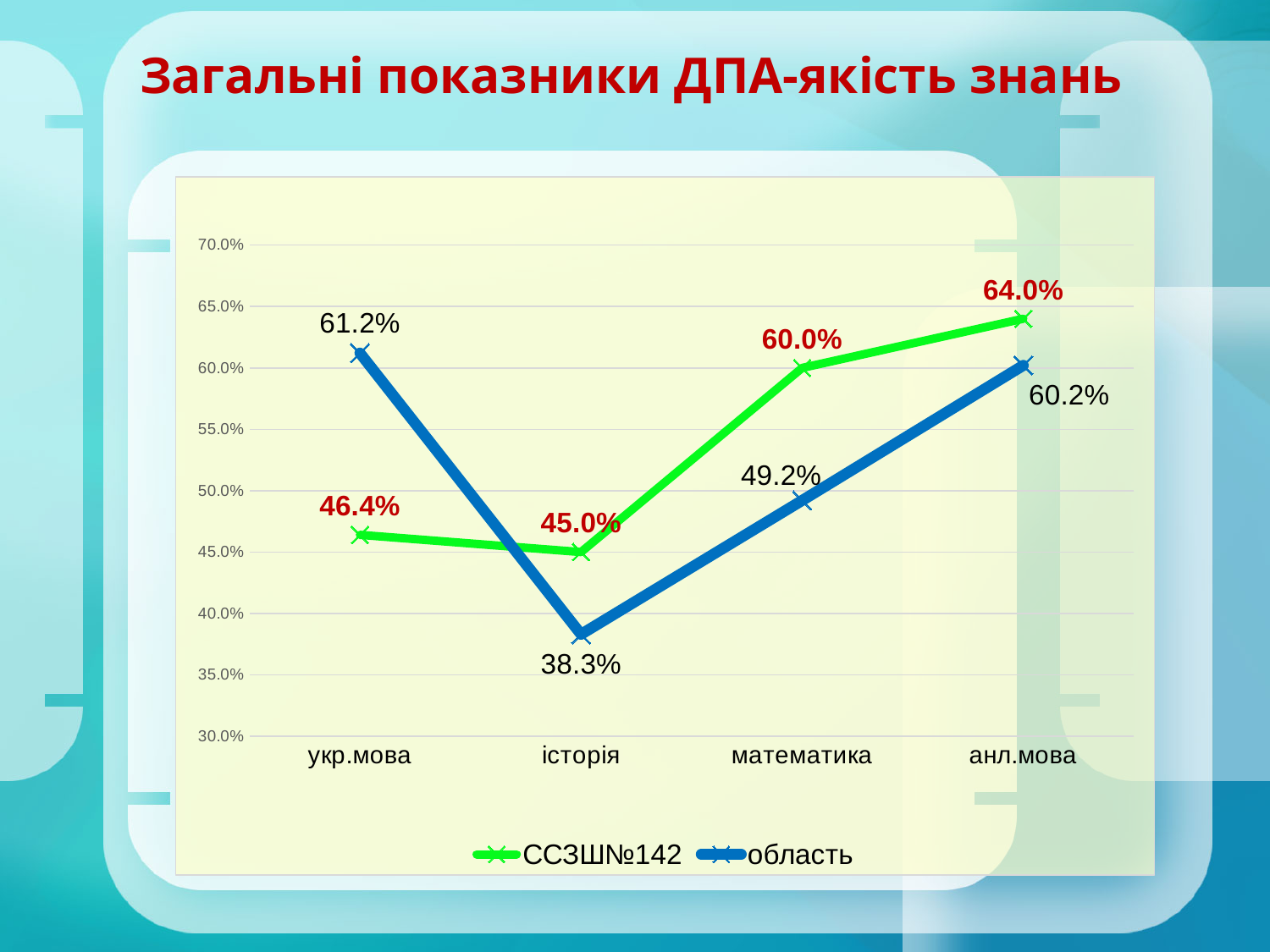
How many categories are shown on the x axis? 4 What is the value for ССЗШ№142 in математика? 60.0% What is the difference between ССЗШ№142 and область in математика? 10.8% What is the value for область in укр.мова? 61.2% What is the title of the slide? Загальні показники ДПА-якість знань What is the value for область in історія? 38.3% Which category has the highest value for ССЗШ№142? анл.мова What kind of chart is shown on the slide? line chart How many series does the legend list? 2 What is the value for ССЗШ№142 in анл.мова? 64.0% Which is larger in укр.мова: ССЗШ№142 or область? область Which category has the lowest value for область? історія